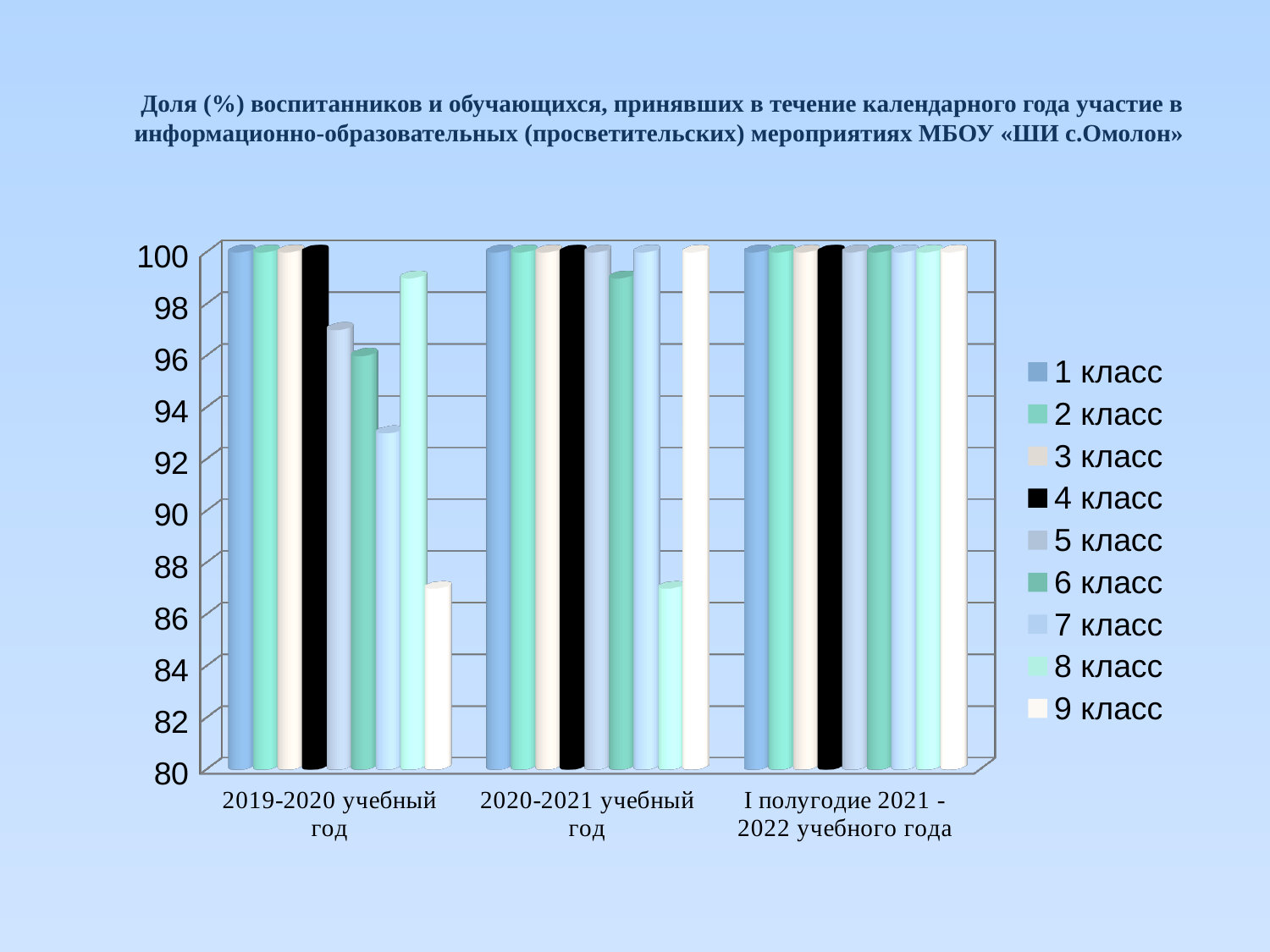
Is the value for 7 класс in 2019-2020 учебный год greater or less than 96? less In 2019-2020 учебный год, which is larger: the value for 5 класс or for 7 класс? 5 класс Is the value for 5 класс in 2019-2020 учебный год greater or less than 94? greater What kind of chart is shown on the slide? bar chart How many series does the legend list? 9 In 2020-2021 учебный год, which class has the lowest value? 8 класс Does the value for 9 класс rise or fall from 2019-2020 учебный год to 2020-2021 учебный год? rises In 2019-2020 учебный год, which class has the lowest value? 9 класс Which series is listed first in the legend? 1 класс How many categories (periods) are shown on the x axis? 3 Is the value for 9 класс in 2019-2020 учебный год greater or less than 90? less